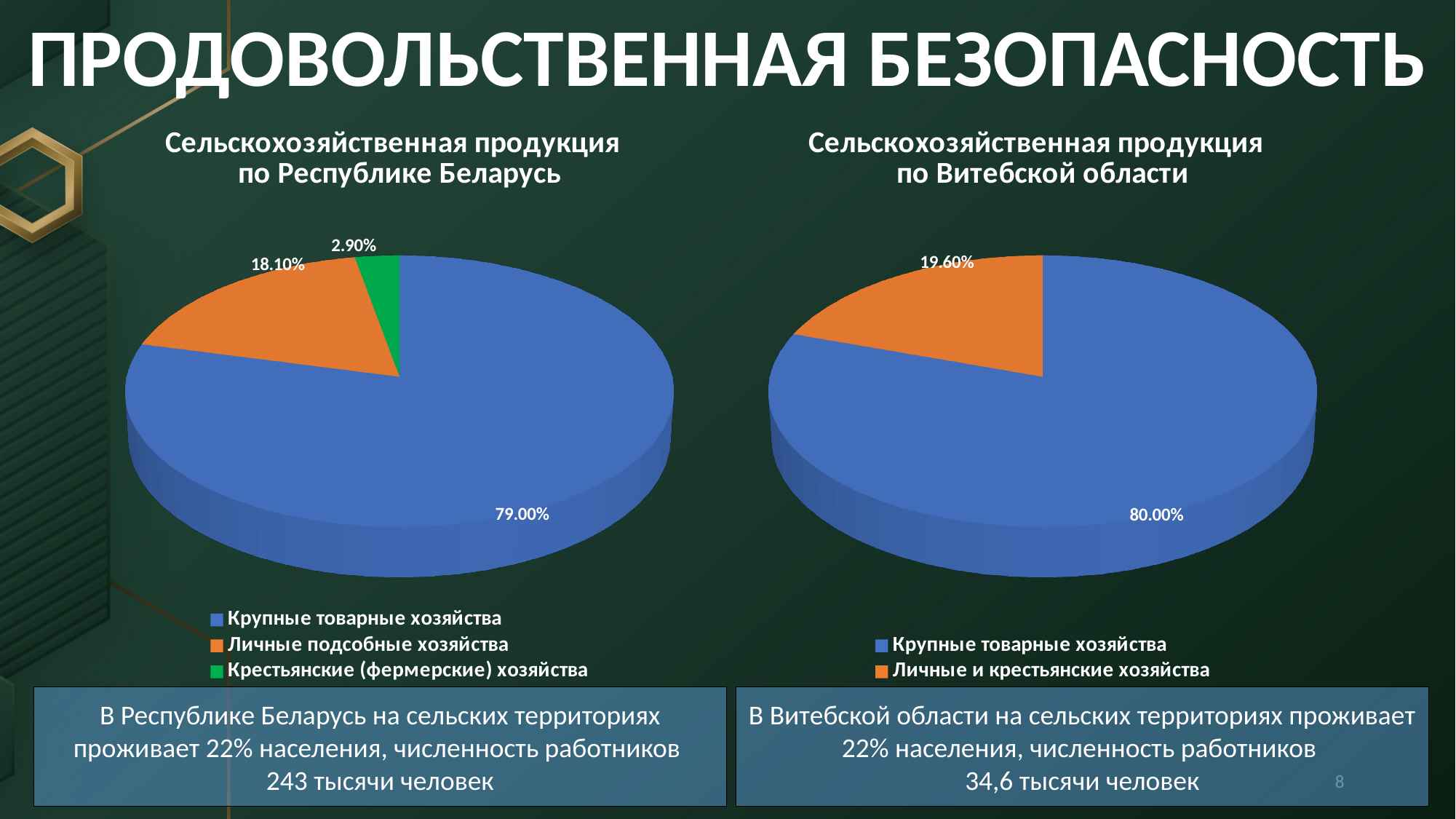
In the chart 'Сельскохозяйственная продукция по Республике Беларусь', how many slices does the pie have? 3 In the chart 'Сельскохозяйственная продукция по Витебской области', how many entries does the legend list? 2 In the chart 'Сельскохозяйственная продукция по Республике Беларусь', which category has the smallest slice? Крестьянские (фермерские) хозяйства In the chart 'Сельскохозяйственная продукция по Республике Беларусь', what is the difference between the shares of Личные подсобные хозяйства and Крестьянские (фермерские) хозяйства? 15.20% What type of chart is used for 'Сельскохозяйственная продукция по Республике Беларусь'? Pie chart Which is larger: the share of Крупные товарные хозяйства in the chart for Республика Беларусь or in the chart for Витебская область? Витебская область In the chart 'Сельскохозяйственная продукция по Витебской области', what share is labelled for Личные и крестьянские хозяйства? 19.60% In the chart 'Сельскохозяйственная продукция по Республике Беларусь', what share is labelled for Крупные товарные хозяйства? 79.00% In the chart 'Сельскохозяйственная продукция по Республике Беларусь', what share is labelled for Крестьянские (фермерские) хозяйства? 2.90% In the chart 'Сельскохозяйственная продукция по Витебской области', which category has the largest slice? Крупные товарные хозяйства In the chart 'Сельскохозяйственная продукция по Республике Беларусь', what share is labelled for Личные подсобные хозяйства? 18.10% In the chart 'Сельскохозяйственная продукция по Витебской области', what share is labelled for Крупные товарные хозяйства? 80.00%